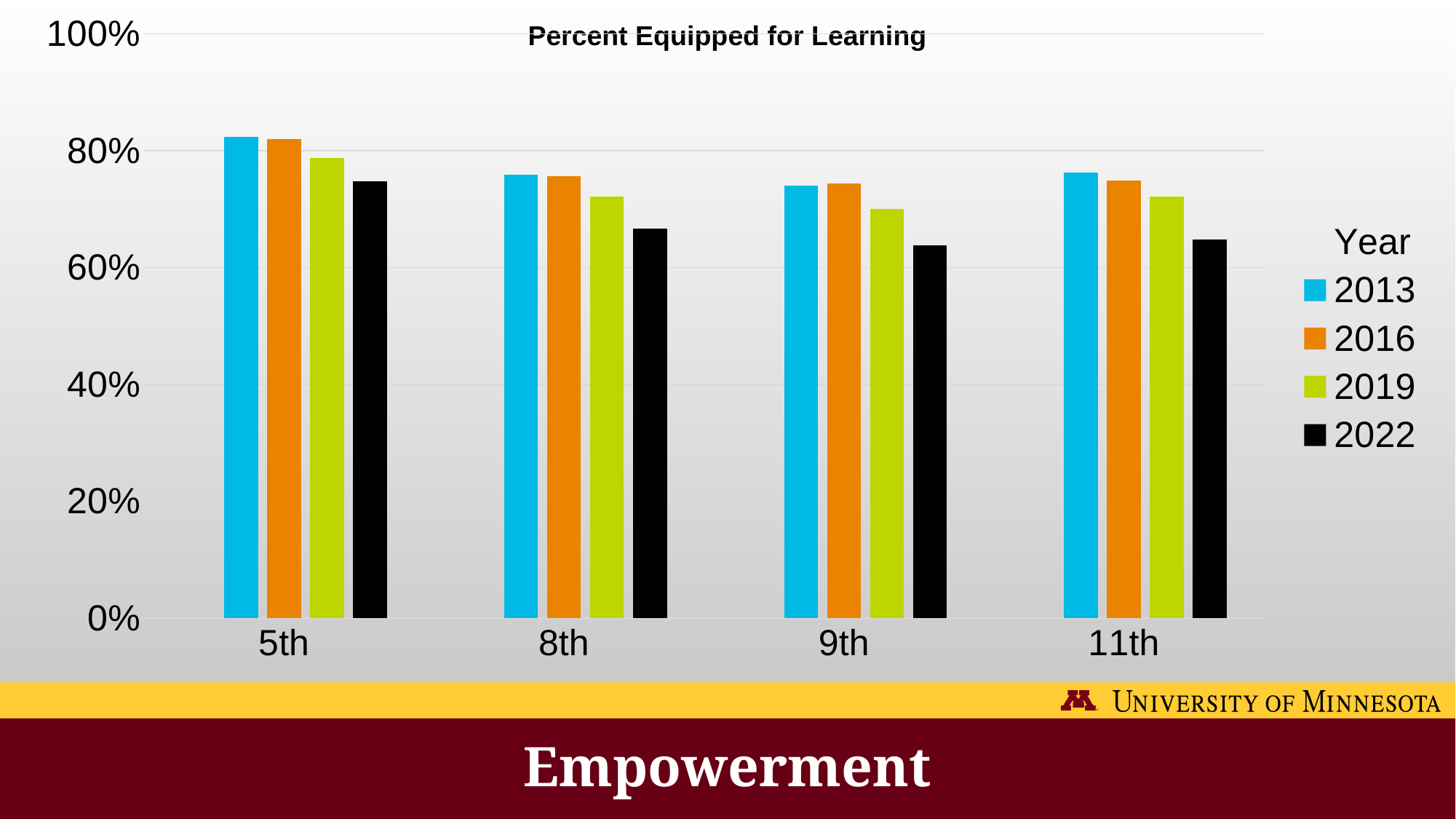
Which grade has the highest value for 2022? 5th Is the value for 5th grade in 2013 greater or less than 80%? greater How many series does the legend list? 4 Which is larger, the 2013 value for 5th grade or the 2013 value for 8th grade? 5th grade Which grade has the highest value for 2019? 5th Which year is represented by the black bars? 2022 What kind of chart is shown on the slide? bar chart How many grade categories are shown on the x axis? 4 Is the value for 8th grade in 2022 greater or less than 80%? less For 8th grade, do the values rise or fall from 2013 to 2022? fall What is the title of the chart? Percent Equipped for Learning Is the value for 9th grade in 2022 greater or less than 60%? greater